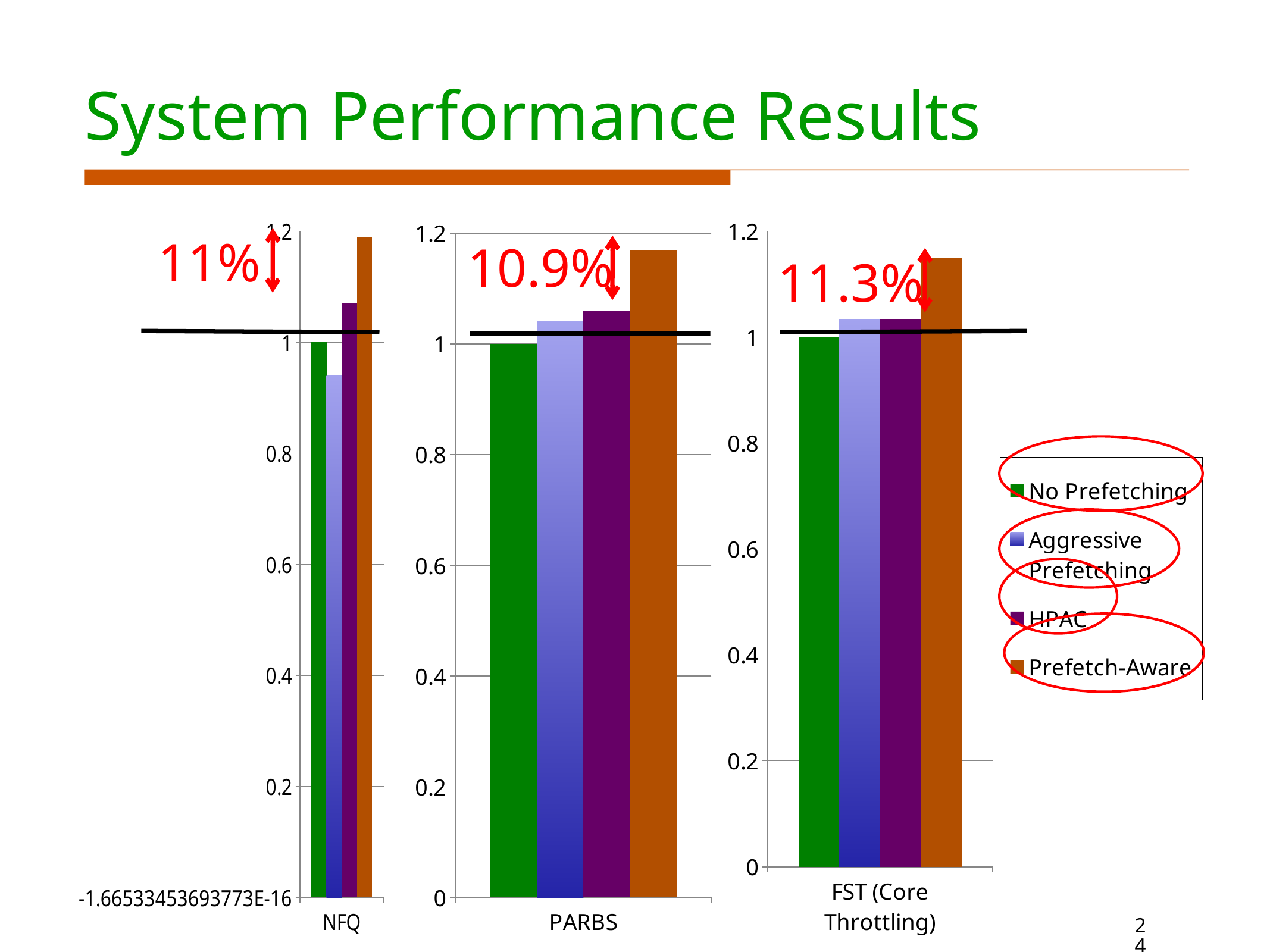
How many series does the legend list? 4 In the NFQ chart, is the value for Aggressive Prefetching greater or less than 1? less In the NFQ chart, which series has the lowest bar? Aggressive Prefetching In the FST (Core Throttling) chart, which series has the highest bar? Prefetch-Aware What kind of chart is the NFQ chart? bar chart In the PARBS chart, which series has the highest bar? Prefetch-Aware In the PARBS chart, which is larger, the bar for No Prefetching or the bar for Prefetch-Aware? Prefetch-Aware In the PARBS chart, is the value for Prefetch-Aware greater or less than 1.2? less What percentage improvement is annotated in red on the PARBS chart? 10.9% How many bar charts are shown on the slide? 3 In the NFQ chart, which series has the highest bar? Prefetch-Aware In the NFQ chart, is the value for Prefetch-Aware greater or less than 1? greater